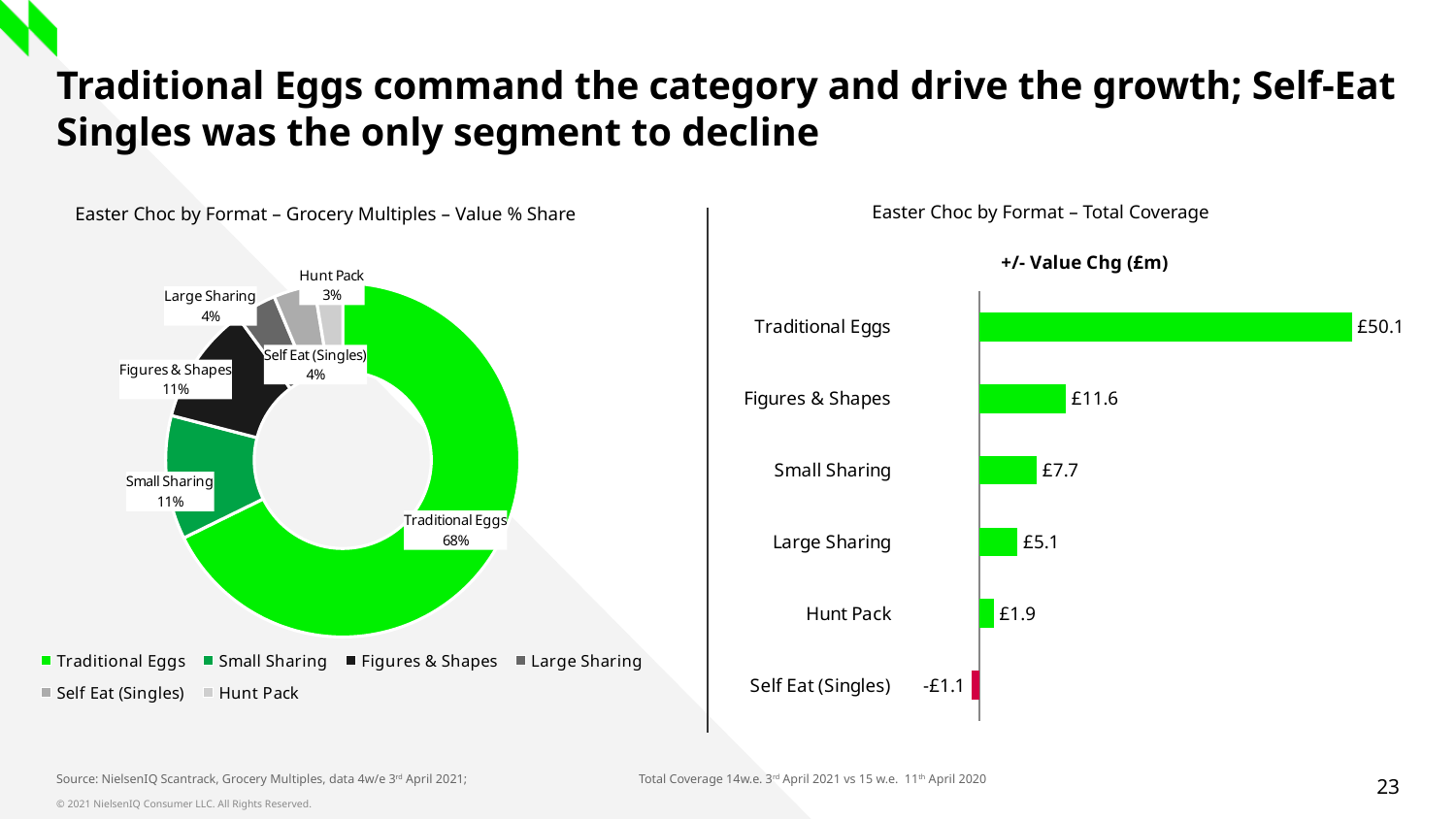
In the 'Easter Choc by Format – Total Coverage' chart, what is the value change for Figures & Shapes? £11.6 What kind of chart is 'Easter Choc by Format – Grocery Multiples – Value % Share'? Donut (pie) chart In the 'Easter Choc by Format – Total Coverage' chart, what is the value change for Self Eat (Singles)? -£1.1 In the 'Easter Choc by Format – Total Coverage' chart, which format has the largest value change? Traditional Eggs In the 'Easter Choc by Format – Grocery Multiples – Value % Share' chart, which format has the smallest share? Hunt Pack In the 'Easter Choc by Format – Total Coverage' chart, which is larger: the value change for Small Sharing or Large Sharing? Small Sharing How many formats does the legend of the 'Easter Choc by Format – Grocery Multiples – Value % Share' chart list? 6 In the 'Easter Choc by Format – Grocery Multiples – Value % Share' chart, what share does Traditional Eggs hold? 68% In the 'Easter Choc by Format – Grocery Multiples – Value % Share' chart, what share does Hunt Pack hold? 3% In the 'Easter Choc by Format – Grocery Multiples – Value % Share' chart, which format has the largest share? Traditional Eggs What kind of chart is 'Easter Choc by Format – Total Coverage'? Bar chart In the 'Easter Choc by Format – Total Coverage' chart, what is the difference between the value change for Traditional Eggs and Figures & Shapes? £38.5